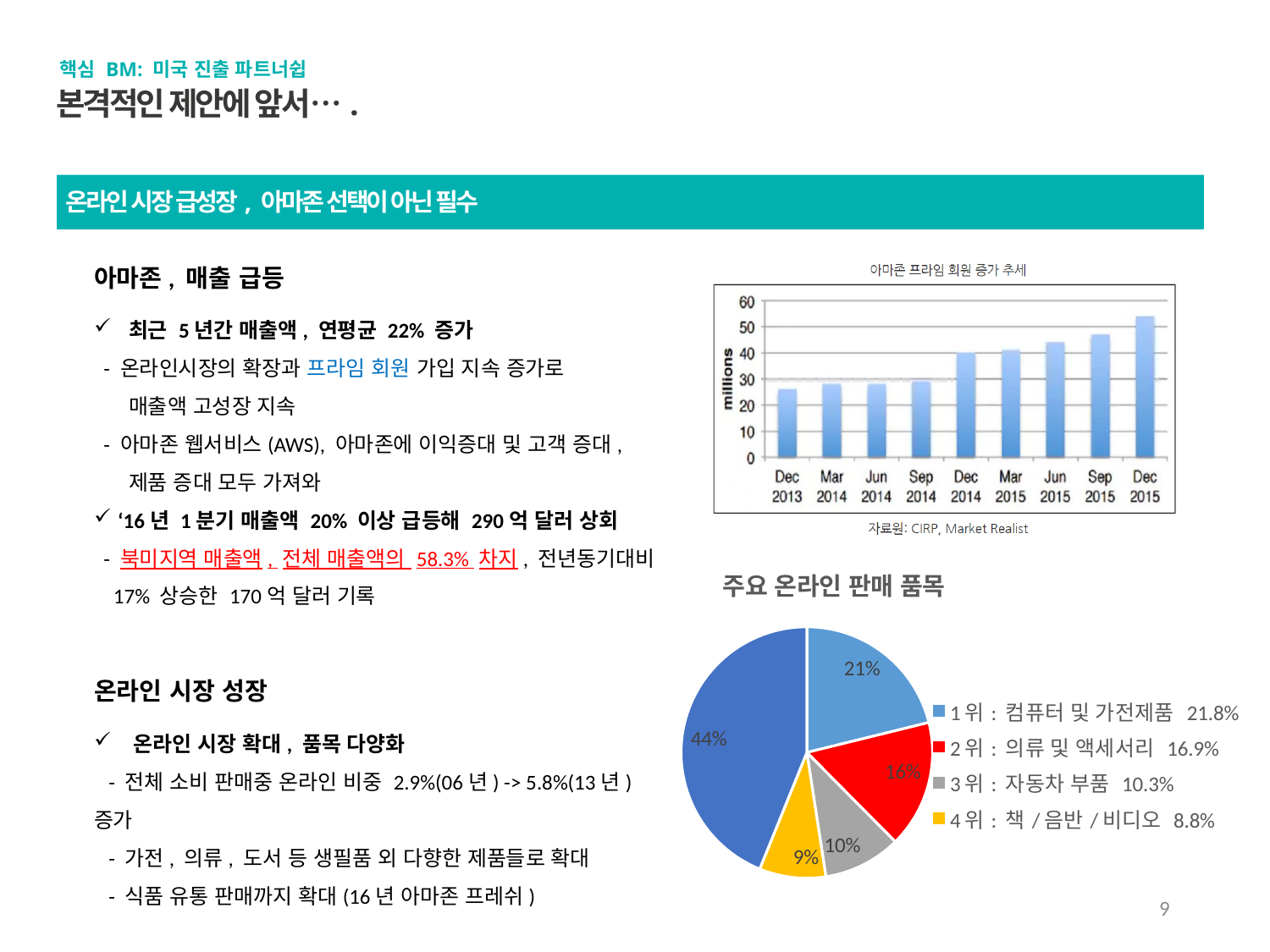
In the '아마존 프라임 회원 증가 추세' chart, do the values generally rise or fall from Dec 2013 to Dec 2015? rise In the '주요 온라인 판매 품목' pie chart, what percentage is shown on the largest slice? 44% In the '아마존 프라임 회원 증가 추세' chart, which period has the highest value? Dec 2015 In the '아마존 프라임 회원 증가 추세' chart, how many bars (time points) are plotted? 9 In the '주요 온라인 판매 품목' pie chart, what percentage does the legend give for '3위 : 자동차 부품'? 10.3% What kind of chart is the '아마존 프라임 회원 증가 추세' chart? bar chart What kind of chart is the '주요 온라인 판매 품목' chart? pie chart In the '아마존 프라임 회원 증가 추세' chart, is the value for Dec 2013 greater or less than 30? less In the '아마존 프라임 회원 증가 추세' chart, which is larger: Sep 2014 or Sep 2015? Sep 2015 How many entries does the legend of the '주요 온라인 판매 품목' pie chart list? 4 In the '아마존 프라임 회원 증가 추세' chart, is the value for Dec 2014 greater or less than 30? greater In the '아마존 프라임 회원 증가 추세' chart, is the value for Dec 2015 greater or less than 50? greater